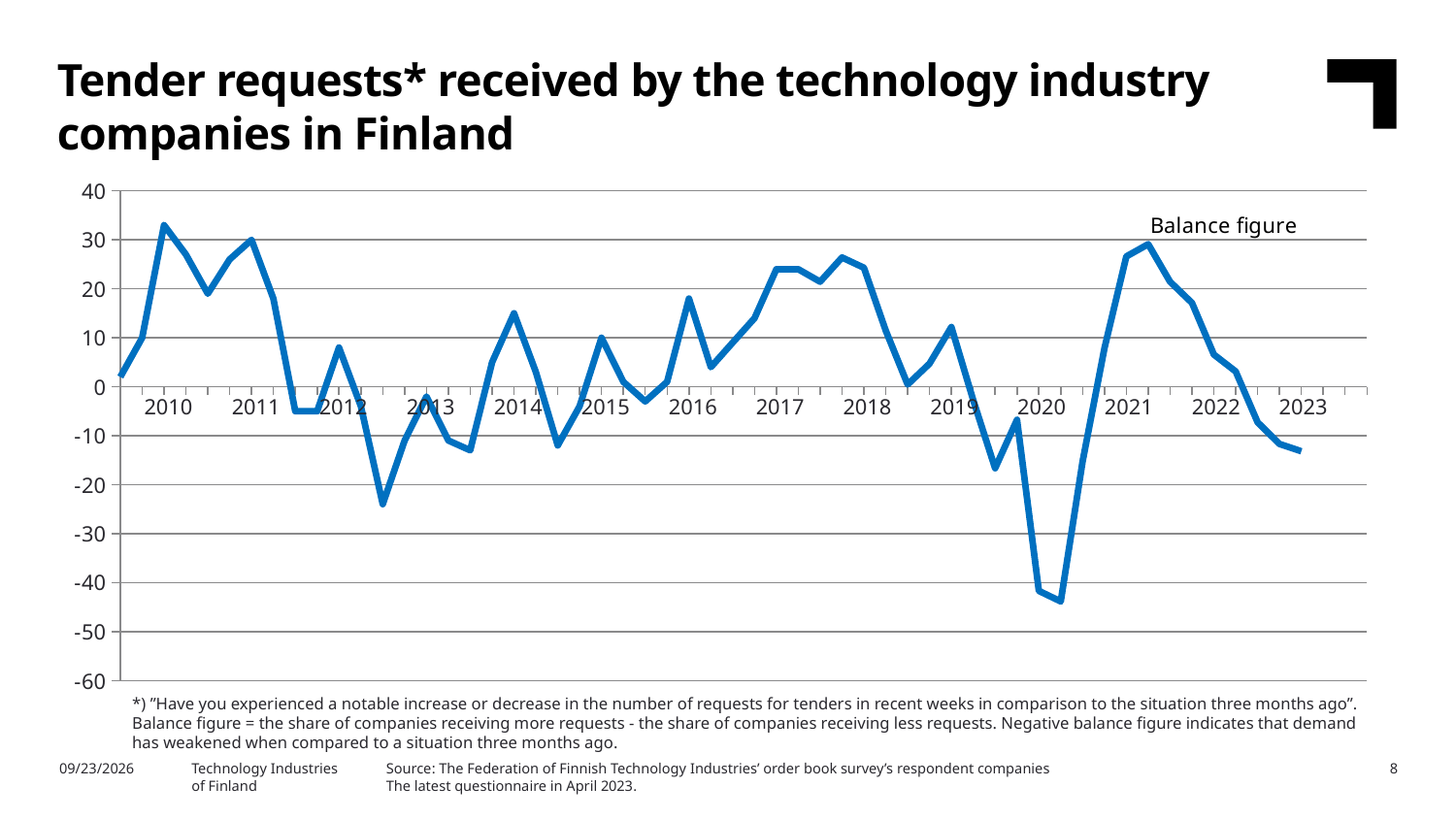
What is the lowest value shown on the vertical axis? -60 Is the lowest value of the balance figure in 2012 greater or less than -20? less Is the lowest value of the balance figure in 2020 greater or less than -40? less Is the last plotted value in 2023 greater or less than 0? less Does the balance figure rise or fall from its 2021 peak to 2023? fall In which year does the balance figure reach its lowest point? 2020 What kind of chart is shown on the slide? line chart Which is larger, the lowest value in 2020 or the lowest value in 2012? the lowest value in 2012